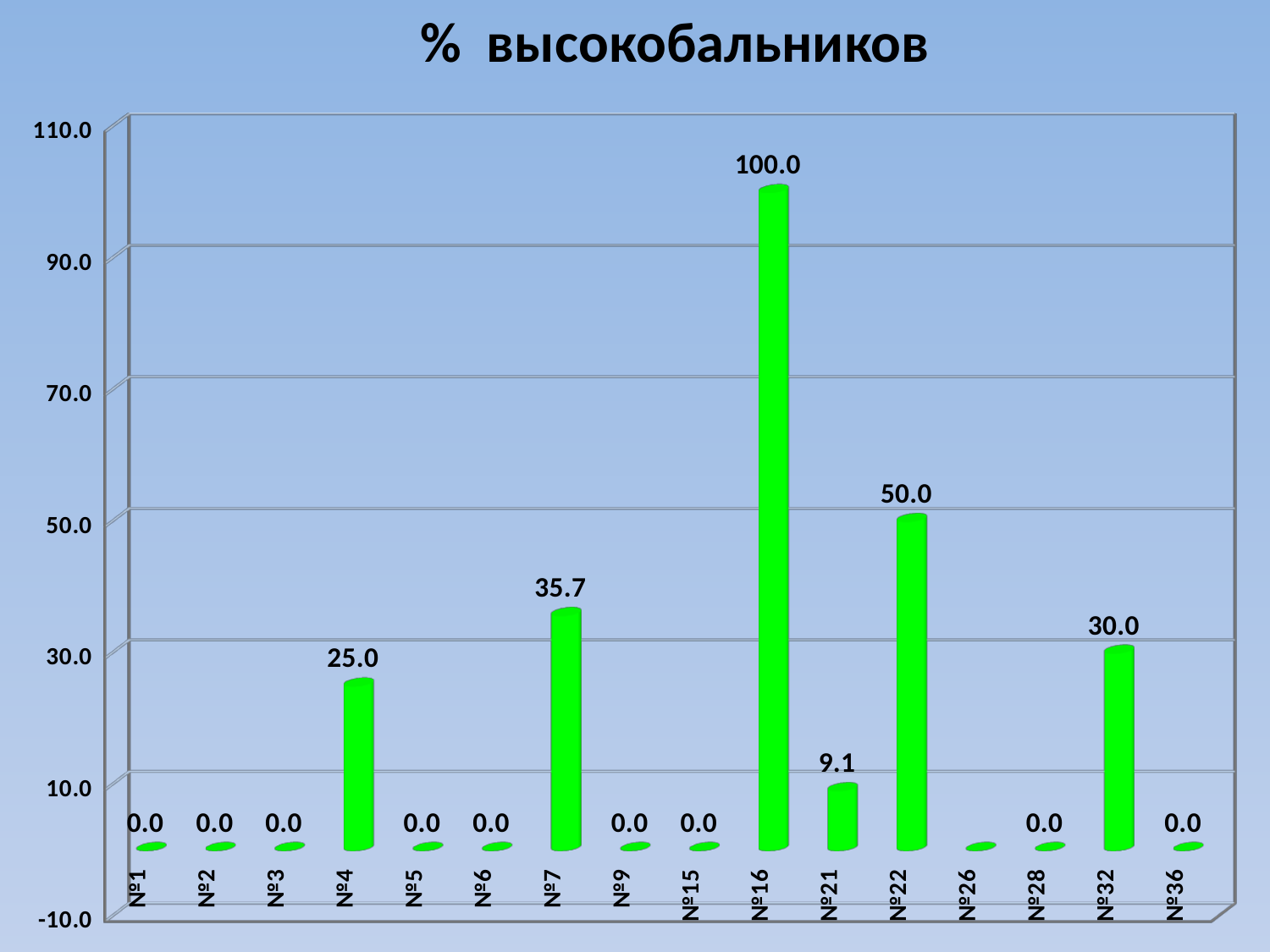
Is the value for №22 greater or less than 30.0? greater What kind of chart is shown on the slide? bar chart Which category has the highest value? №16 What is the title of the chart? % высокобальников What is the difference between the values for №22 and №4? 25.0 How many categories are shown on the x axis? 16 What is the difference between the values for №16 and №22? 50.0 What is the value for №7? 35.7 Which is larger, the value for №7 or the value for №32? №7 What is the value for №21? 9.1 What is the value for №16? 100.0 What is the value for №32? 30.0